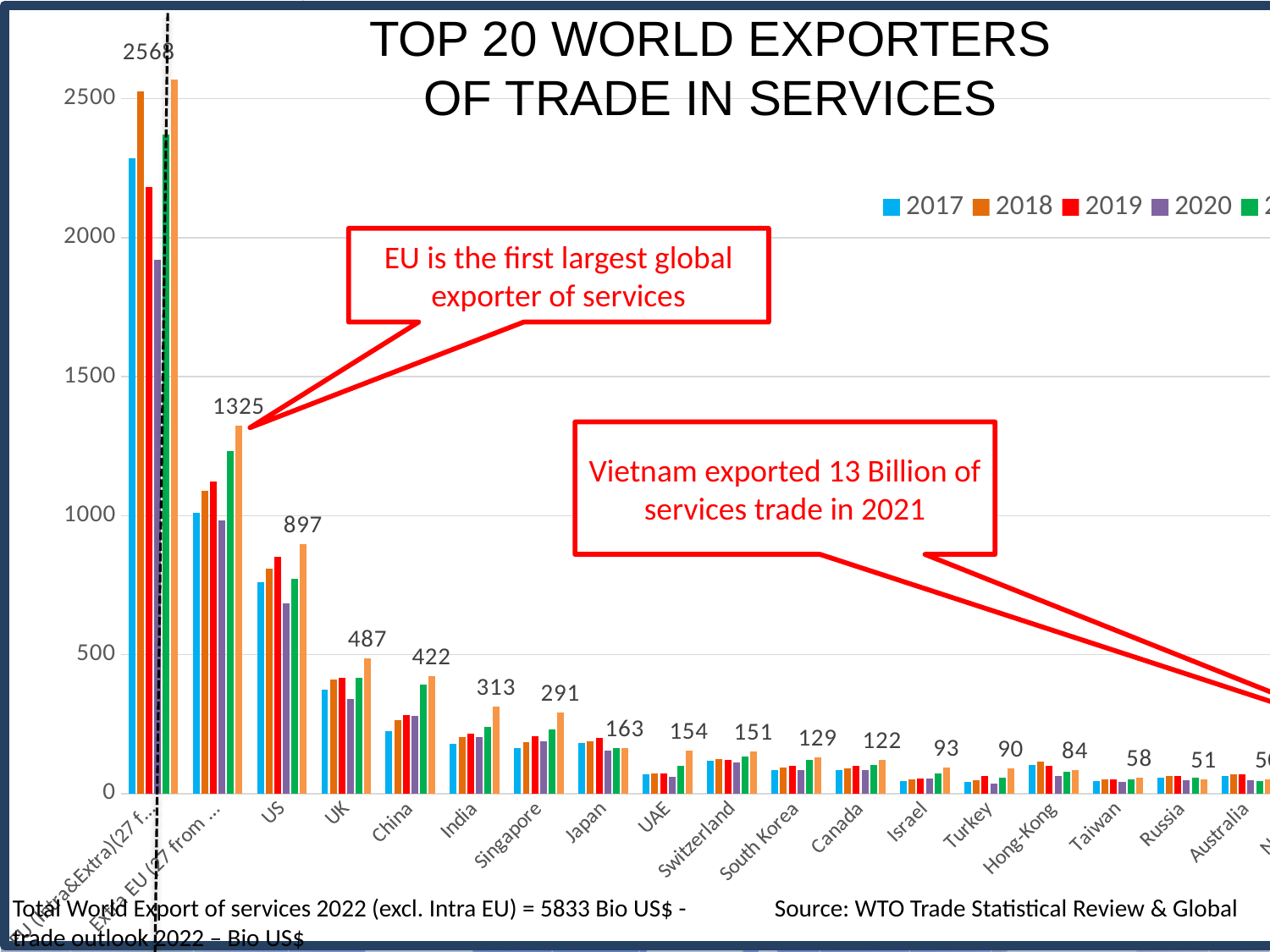
What colour does the legend use for the 2019 series? red Among US, UK and China, which has the highest labelled value? US What kind of chart is shown on the slide? bar chart What is the data label printed above the UK group of bars? 487 Which has the larger labelled value, UAE or Switzerland? UAE What is the difference between the labelled values for Canada (122) and Israel (93)? 29 What is the difference between the labelled values for India (313) and Singapore (291)? 22 Is the 2017 bar for the US greater or less than 500? greater What is the data label printed above the US group of bars? 897 What is the data label printed above the Japan group of bars? 163 What is the data label printed above the China group of bars? 422 Among Hong-Kong, Taiwan and Russia, which has the lowest labelled value? Russia